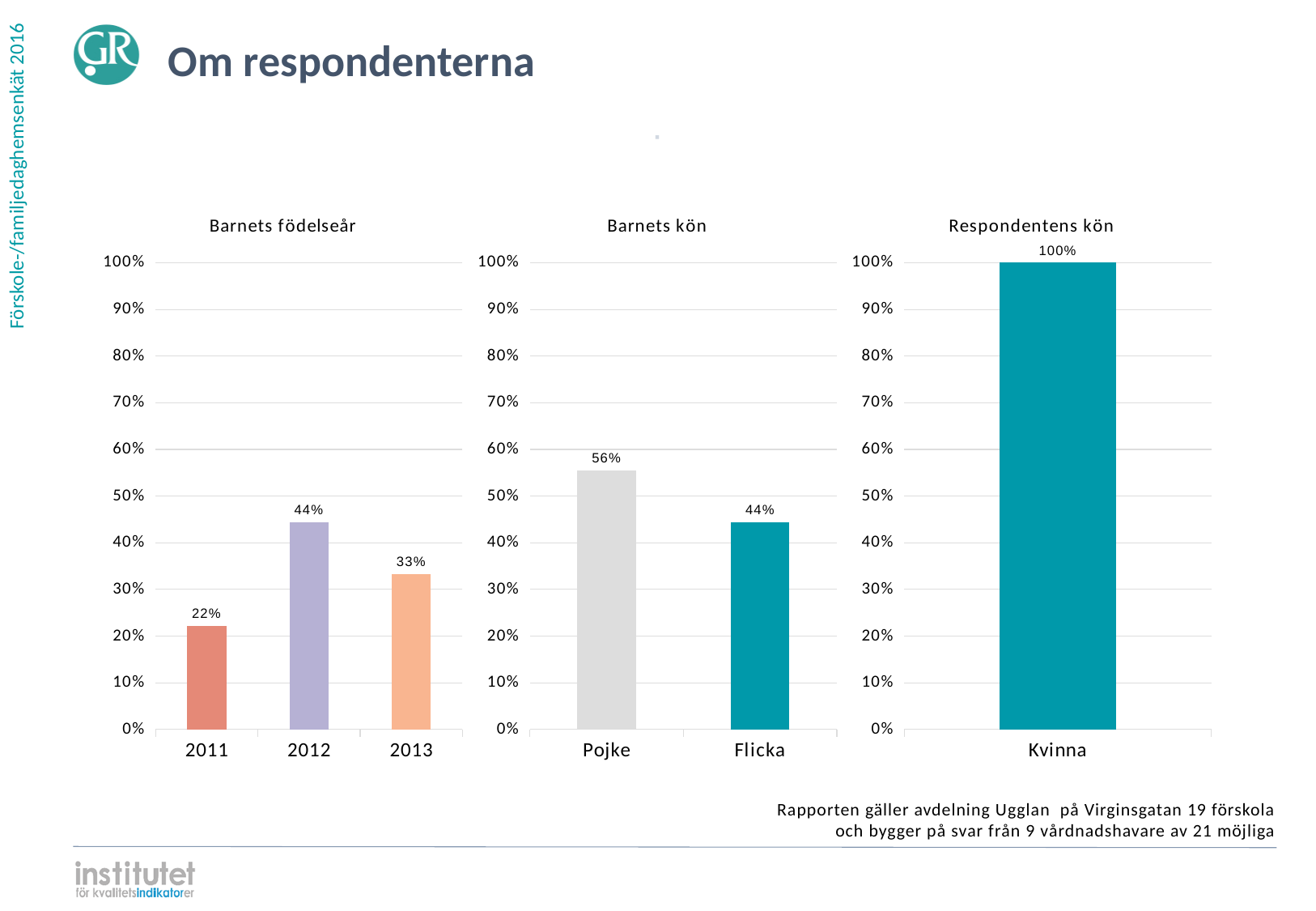
In the 'Barnets födelseår' chart, is the value for 2013 greater or less than 30%? greater In the 'Barnets födelseår' chart, what is the difference between the values for 2012 and 2011? 22% What kind of chart is the 'Barnets kön' chart? Bar chart In the 'Barnets födelseår' chart, which year has the lowest value? 2011 In the 'Barnets kön' chart, what is the value for Pojke? 56% In the 'Respondentens kön' chart, what is the value for Kvinna? 100% In the 'Barnets kön' chart, which is larger, Pojke or Flicka? Pojke In the 'Barnets födelseår' chart, what is the value for 2012? 44% In the 'Barnets födelseår' chart, how many categories are shown on the x axis? 3 In the 'Barnets födelseår' chart, which year has the highest value? 2012 In the 'Respondentens kön' chart, how many categories are shown? 1 In the 'Barnets kön' chart, what is the difference between Pojke and Flicka? 12%